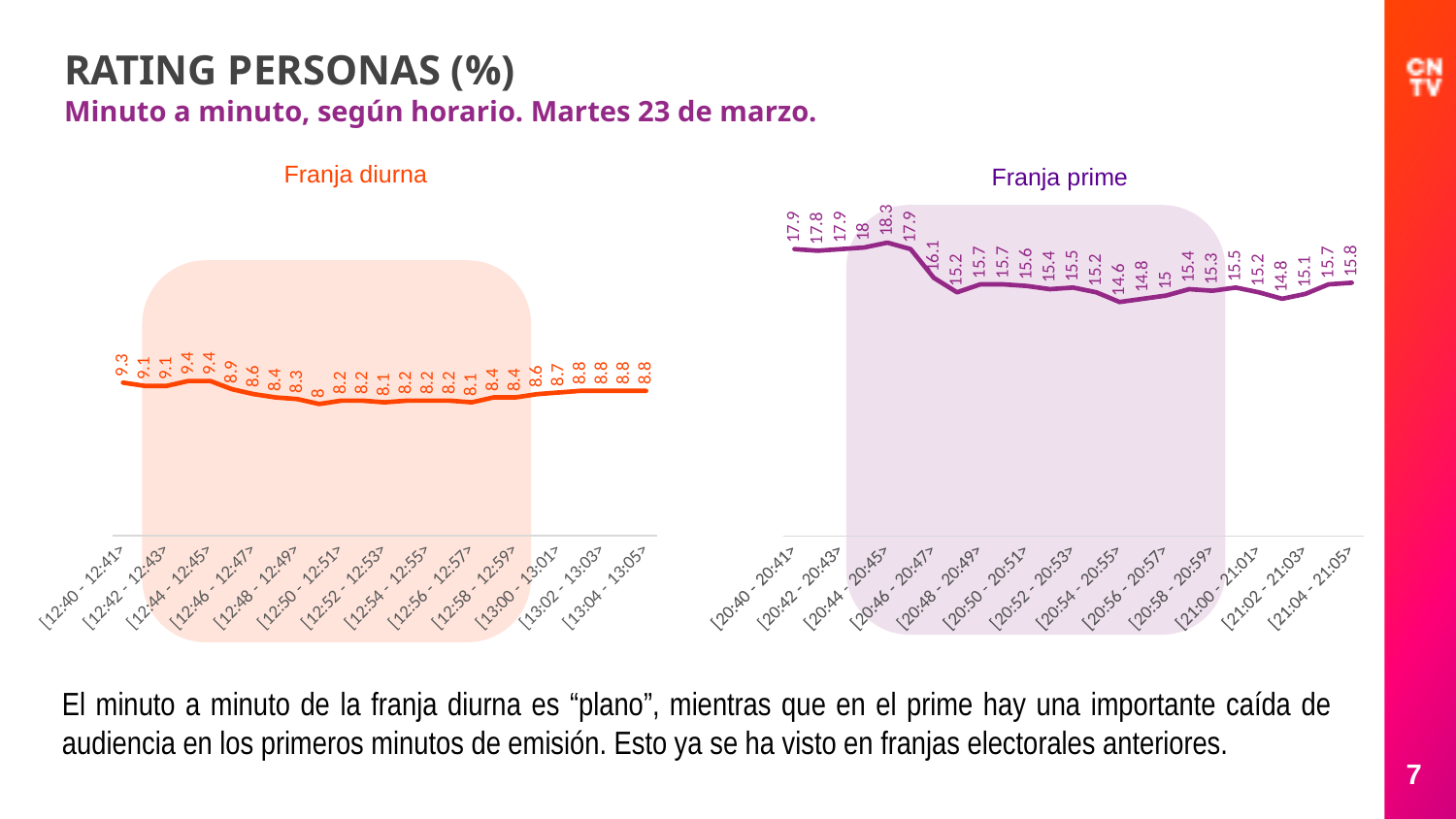
In the Franja prime chart, what is the difference between the highest and lowest values? 3.7 In the Franja prime chart, what is the highest value shown? 18.3 In the Franja prime chart, what is the value of the last data point? 15.8 What kind of chart is used for the Franja diurna data? line chart In the Franja prime chart, do the values overall rise or fall from the first point to the last point? fall Which is larger: the first value of the Franja prime chart or the first value of the Franja diurna chart? Franja prime In the Franja diurna chart, what is the highest value shown? 9.4 In the Franja prime chart, what is the lowest value shown? 14.6 In the Franja diurna chart, what is the lowest value shown? 8 In the Franja diurna chart, what is the value of the first data point? 9.3 In the Franja diurna chart, what is the value of the last data point? 8.8 What is the main title of the slide above the charts? RATING PERSONAS (%)